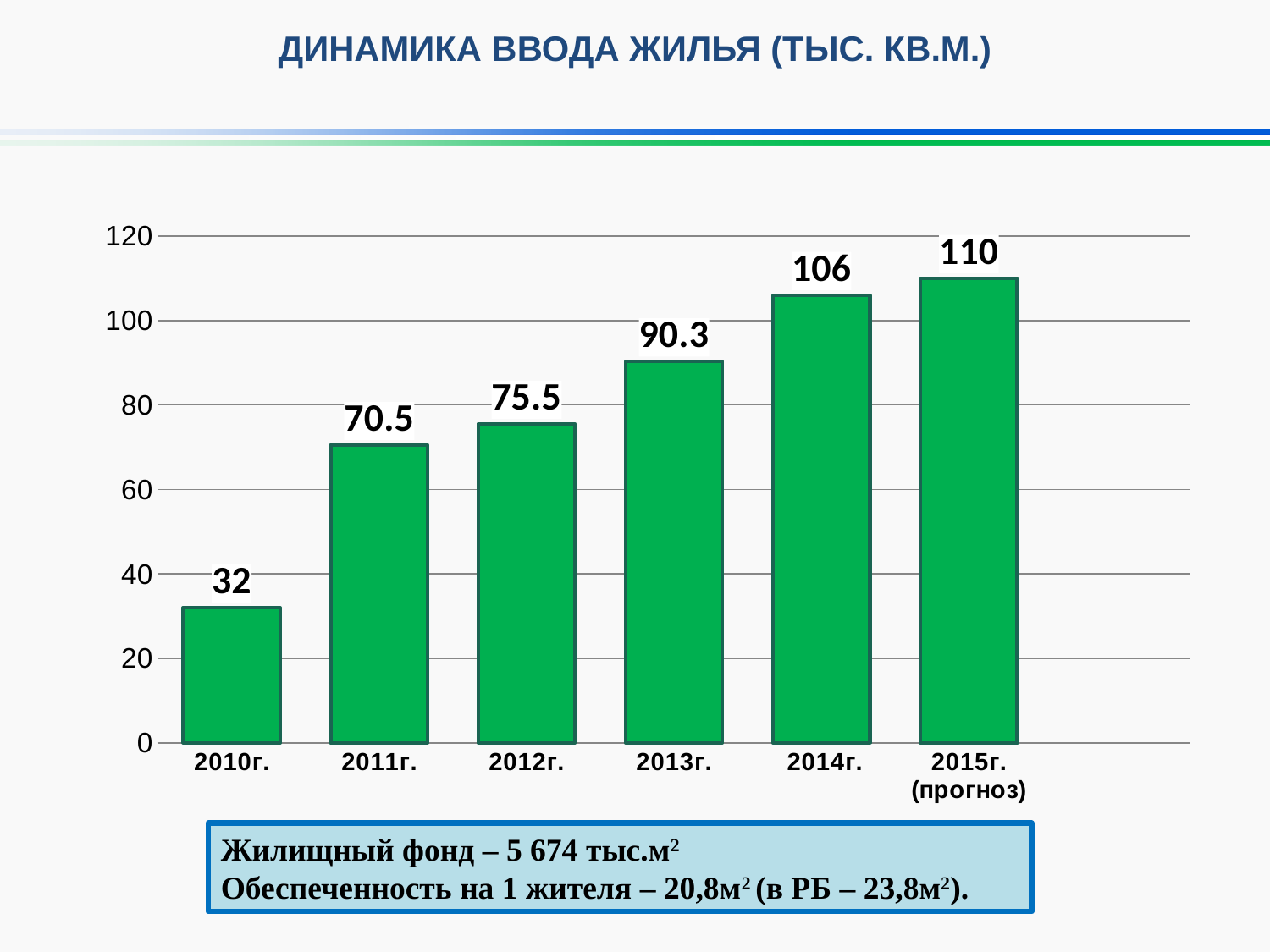
What is the difference between the values for 2014г. and 2013г.? 15.7 What is the value for 2015г. (прогноз)? 110 Do the values rise or fall from 2010г. to 2015г. (прогноз)? rise What kind of chart is shown on the slide? bar chart Which year has the highest value? 2015г. (прогноз) What is the difference between the values for 2011г. and 2010г.? 38.5 How many years are shown on the x axis? 6 What is the value for 2013г.? 90.3 Which year has the lowest value? 2010г. Which is larger, the value for 2012г. or the value for 2011г.? 2012г. Is the value for 2014г. greater or less than 100? greater What is the value for 2010г.? 32